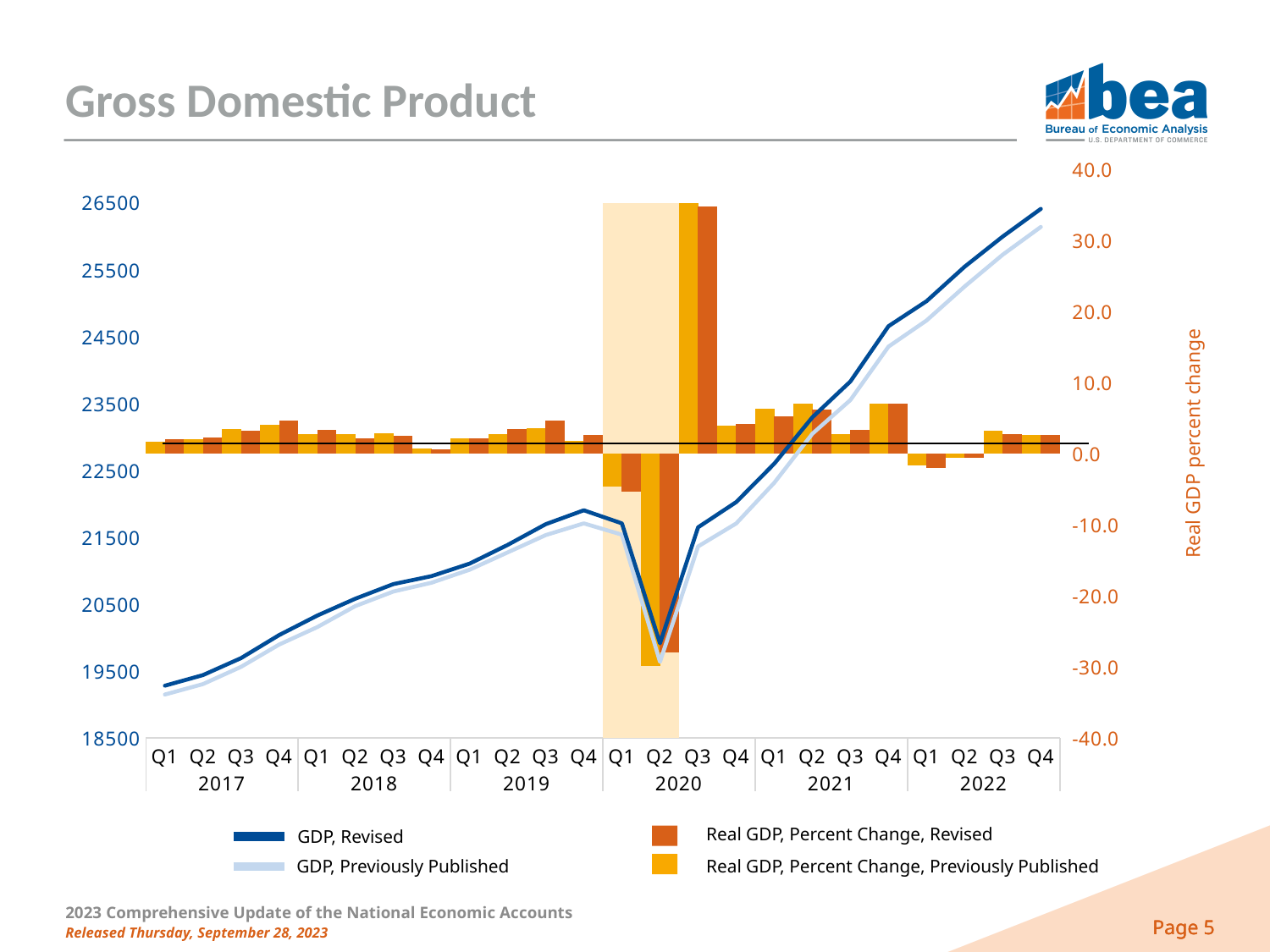
In which quarter is the Real GDP, Percent Change, Revised bar highest? Q3 2020 How many years are labelled on the x axis? 6 Is the Real GDP, Percent Change, Revised value for Q3 2020 greater or less than 30.0? greater Is the Real GDP, Percent Change, Revised value for Q2 2020 greater or less than -20.0? less How many quarterly points are plotted along the x axis? 24 What kind of chart is shown on the slide? A combined line and bar chart What is the title of the right-hand vertical axis? Real GDP percent change Is the GDP, Revised value for Q4 2022 greater or less than 25500? greater In which quarter is the Real GDP, Percent Change, Revised bar lowest? Q2 2020 Which is larger in Q4 2022, GDP, Revised or GDP, Previously Published? GDP, Revised How many series does the legend list? 4 Does the GDP, Revised line generally rise or fall from Q1 2017 to Q4 2022? Rise